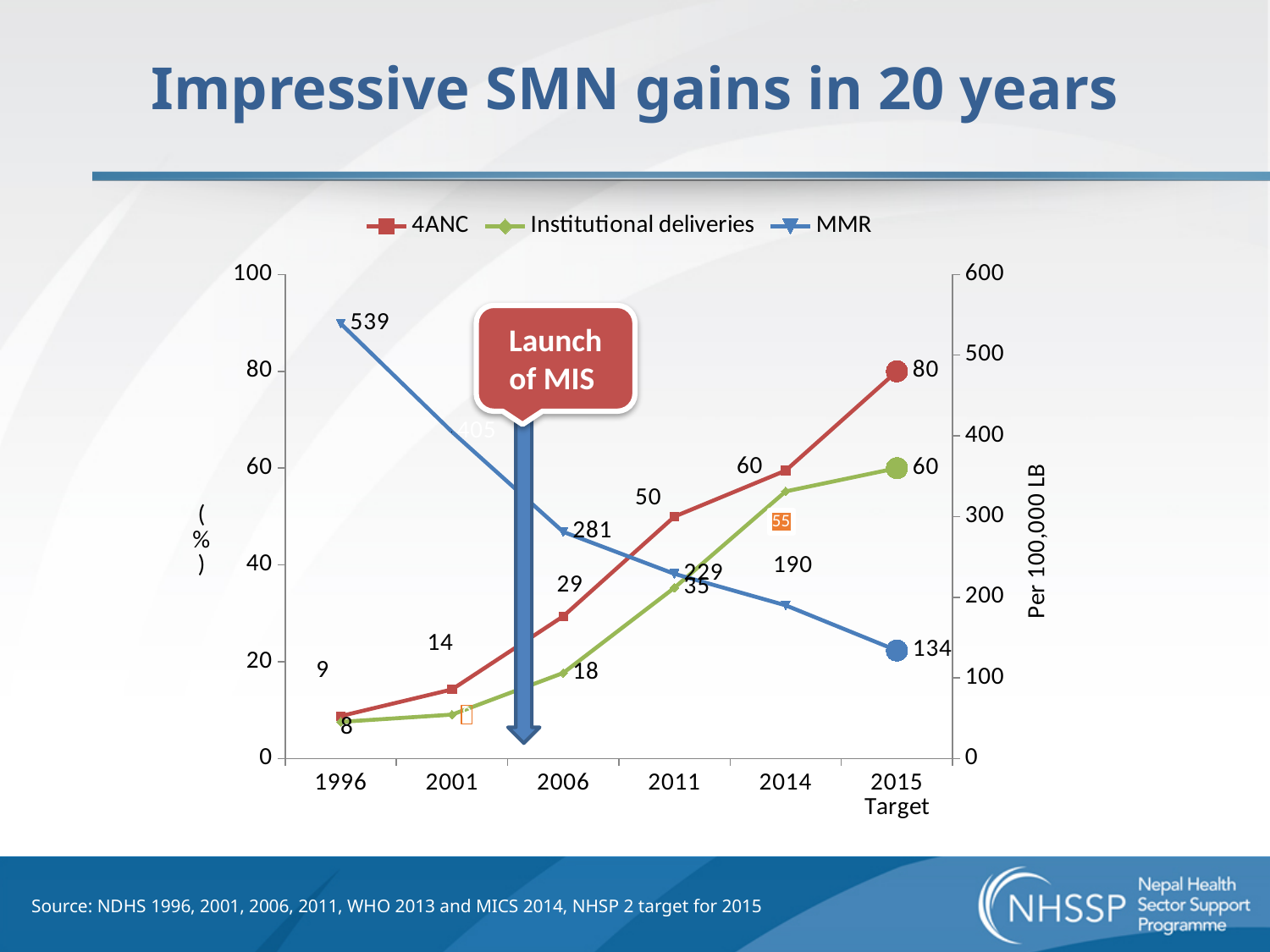
How many series does the legend list? 3 By how much did MMR fall between 2006 and 2011? 52 What is the difference between the 4ANC value for the 2015 Target and for 2014? 20 What is the MMR value for 1996? 539 What is the Institutional deliveries value for the 2015 Target? 60 In which year is the 4ANC value lowest? 1996 What is the Institutional deliveries value for 2014? 55 Does the MMR line rise or fall from 1996 to the 2015 Target? Fall What is the MMR value for the 2015 Target? 134 What is the 4ANC value for 2011? 50 In which year is MMR highest? 1996 In 2014, which is larger: 4ANC or Institutional deliveries? 4ANC